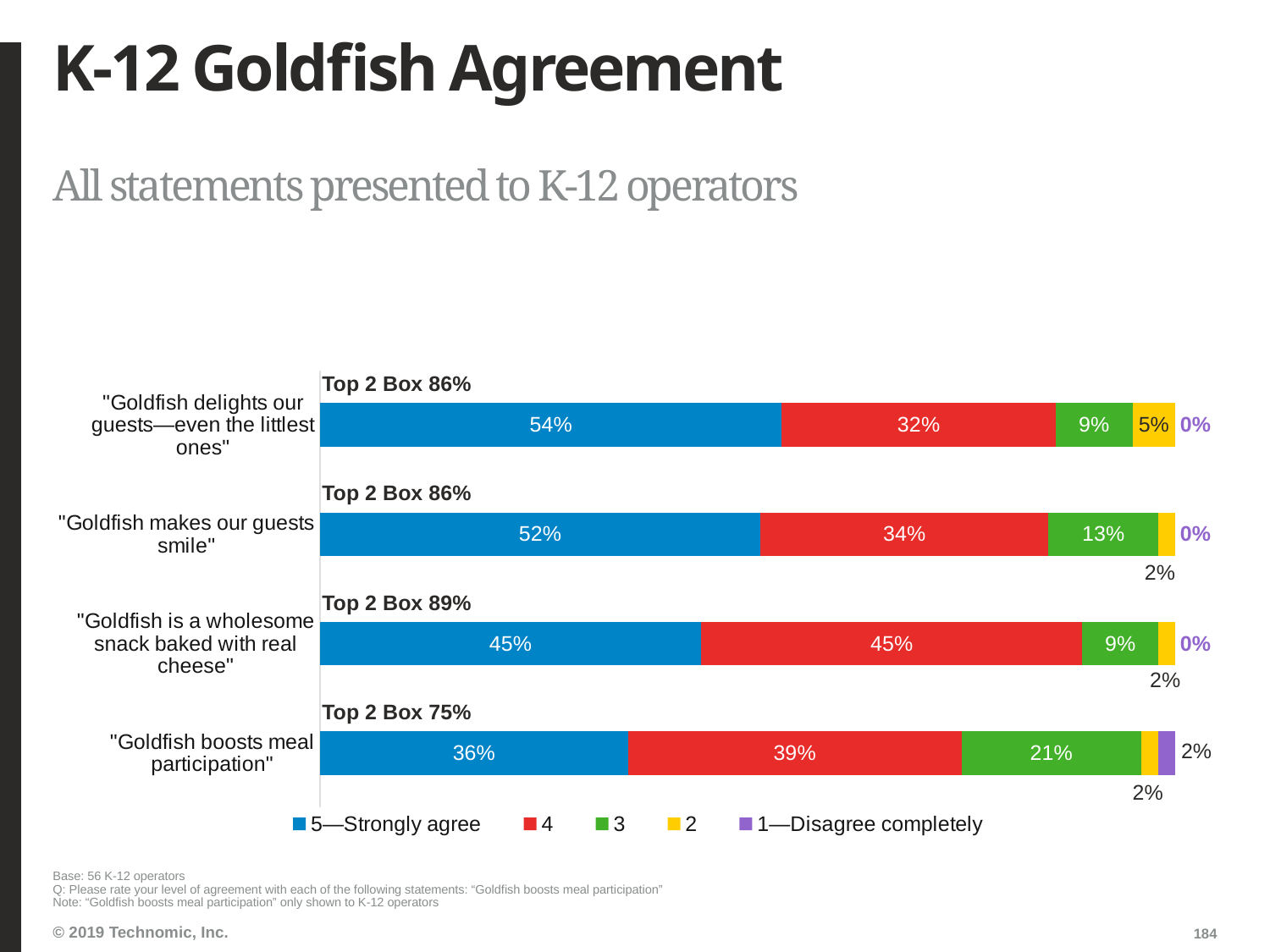
How many statements are shown in the chart? 4 Which statement has the highest Top 2 Box score? "Goldfish is a wholesome snack baked with real cheese" What percentage rated "Goldfish boosts meal participation" as 1—Disagree completely? 2% Which statement has the lowest share of 5—Strongly agree responses? "Goldfish boosts meal participation" What is the base size noted for the chart? 56 K-12 operators Which is larger: the share rating "Goldfish is a wholesome snack baked with real cheese" a 4, or the share rating "Goldfish makes our guests smile" a 4? "Goldfish is a wholesome snack baked with real cheese" What is the Top 2 Box score for "Goldfish boosts meal participation"? 75% What kind of chart is shown on the slide? Stacked bar chart What percentage of K-12 operators strongly agree (5) that "Goldfish delights our guests—even the littlest ones"? 54% What percentage rated "Goldfish makes our guests smile" a 3? 13% How many series does the legend list? 5 What is the difference between the 5—Strongly agree shares for "Goldfish delights our guests—even the littlest ones" and "Goldfish boosts meal participation"? 18%